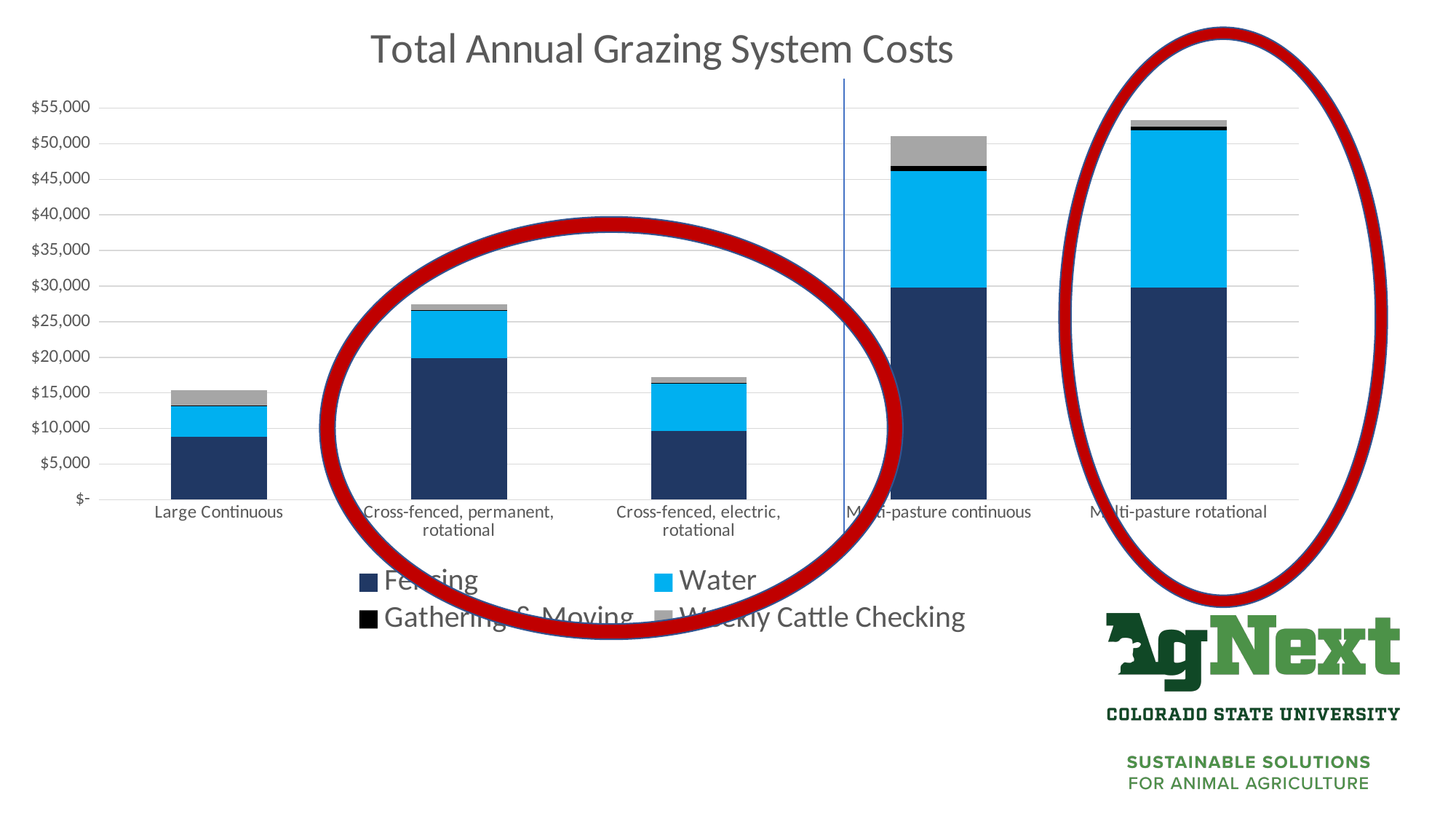
Which series is shown in light blue? Water Is the total cost for Large Continuous greater or less than $20,000? less Is the Fencing cost for Multi-pasture rotational greater or less than $25,000? greater Is the total cost for Multi-pasture continuous greater or less than $45,000? greater Which has a higher total cost: Cross-fenced, permanent, rotational or Cross-fenced, electric, rotational? Cross-fenced, permanent, rotational What is the title of the chart? Total Annual Grazing System Costs How many series does the legend list? 4 What kind of chart is shown on the slide? Stacked bar chart Which has a higher total cost: Large Continuous or Multi-pasture continuous? Multi-pasture continuous How many grazing systems (categories) are shown on the x axis? 5